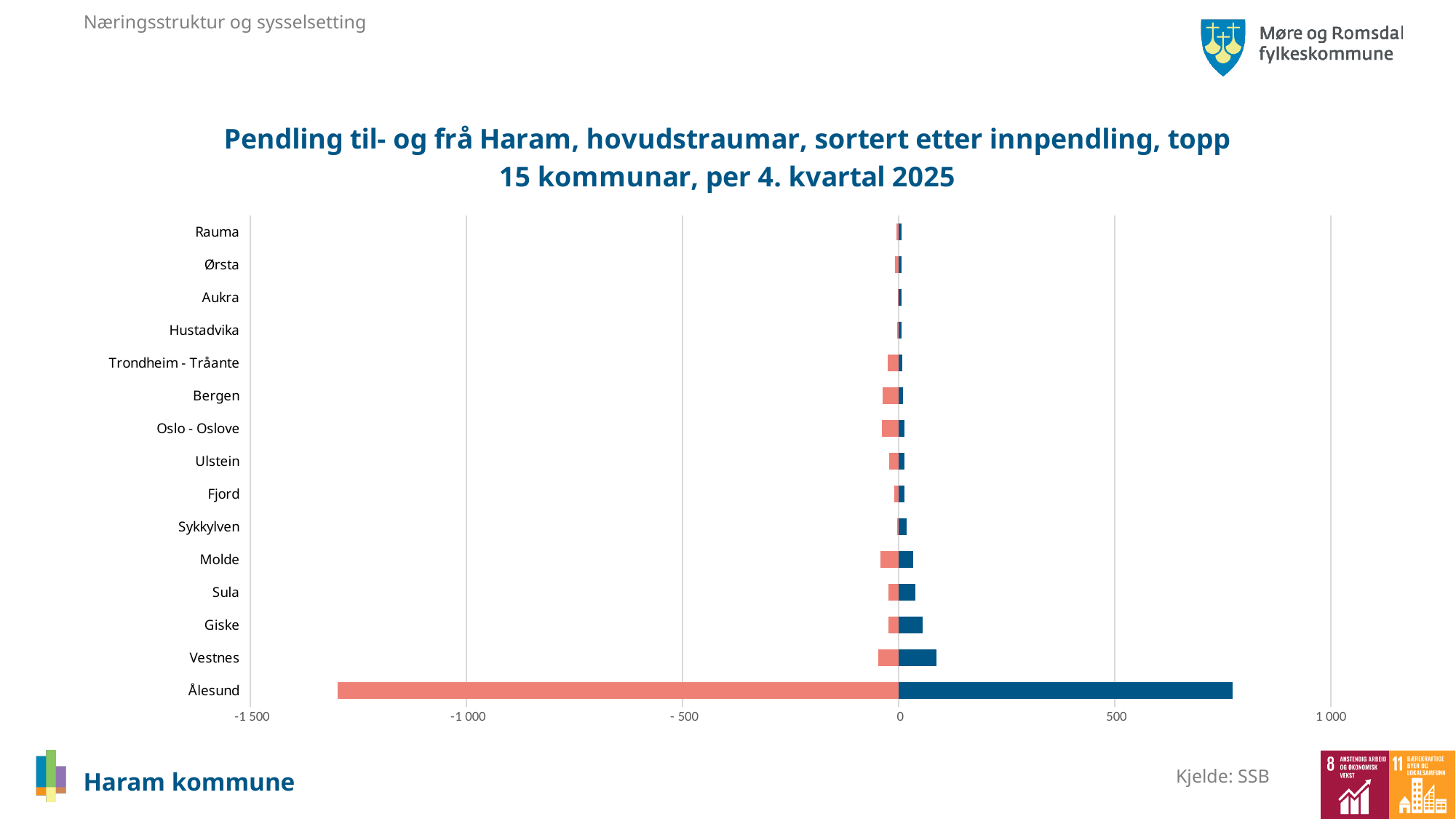
Is the blue bar value for Ålesund greater or less than 500? greater According to the title, which quarter and year does the chart's data refer to? 4. kvartal 2025 What kind of chart is shown on the slide? bar chart Which municipality has the longest blue (positive) bar in the chart? Ålesund Is the blue bar value for Vestnes greater or less than 500? less What is the lowest value shown on the horizontal axis of the chart? -1 500 Which municipality has the longest red (negative) bar in the chart? Ålesund How many municipalities (categories) are listed on the vertical axis of the chart? 15 Is the red bar value for Ålesund greater or less than -1 000? less Which has the larger blue bar, Ålesund or Vestnes? Ålesund Which has the larger blue bar, Giske or Rauma? Giske